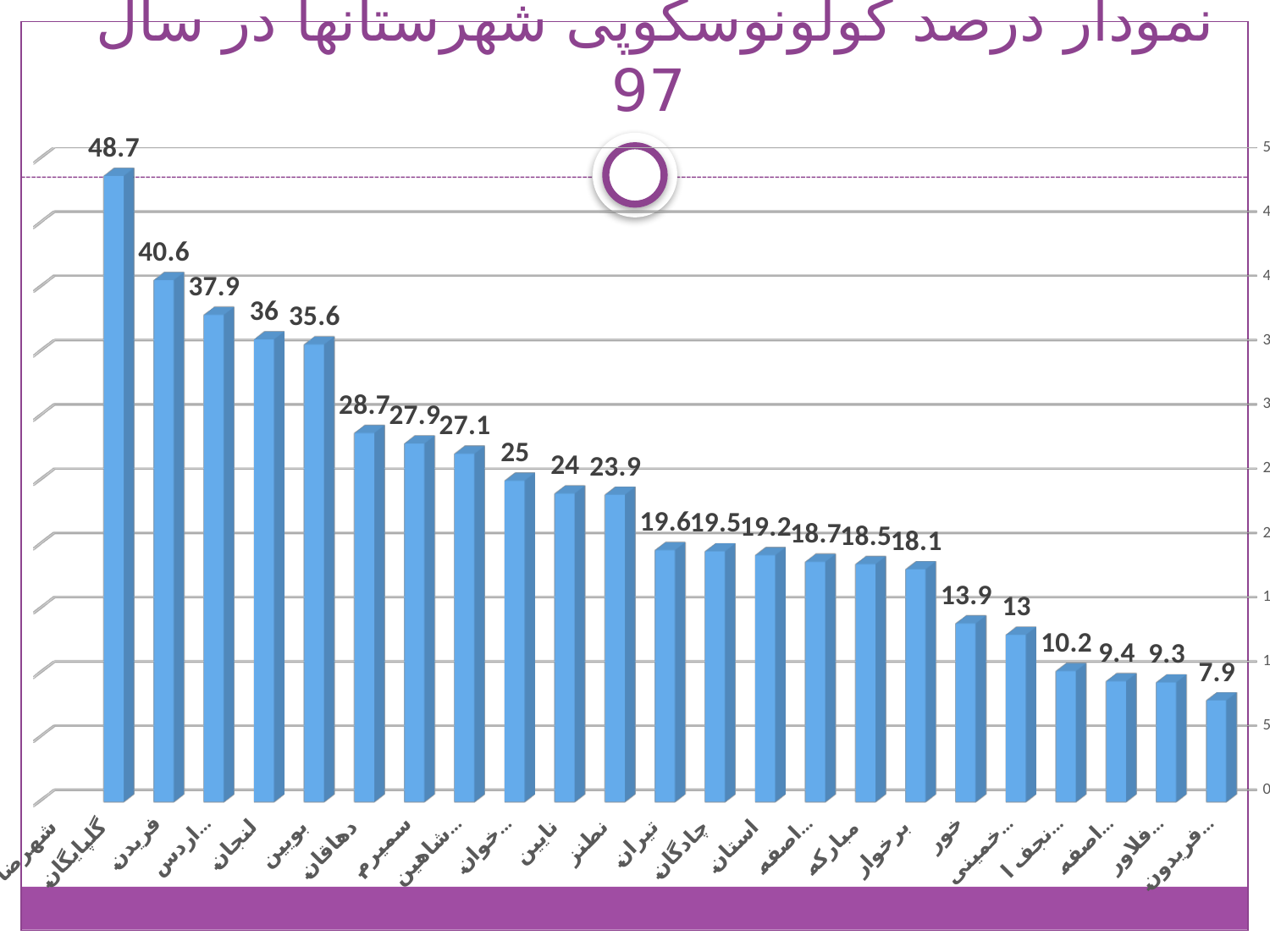
What year is mentioned in the chart title? 97 What is the difference between the highest value (48.7) and the lowest value (7.9)? 40.8 What is the value shown for لنجان? 36 What is the value shown for مبارکه? 18.5 What is the value shown for فلاور? 9.3 Which category has the lowest value in the chart? فریدون What is the value shown for خور? 13.9 Which has a larger value, لنجان or نایین? لنجان What is the value shown for فریدون (the last bar on the right)? 7.9 Do the bar values rise or fall from left to right across the chart? fall What type of chart is shown on the slide? bar chart Which category has the highest value in the chart? گلپایگان